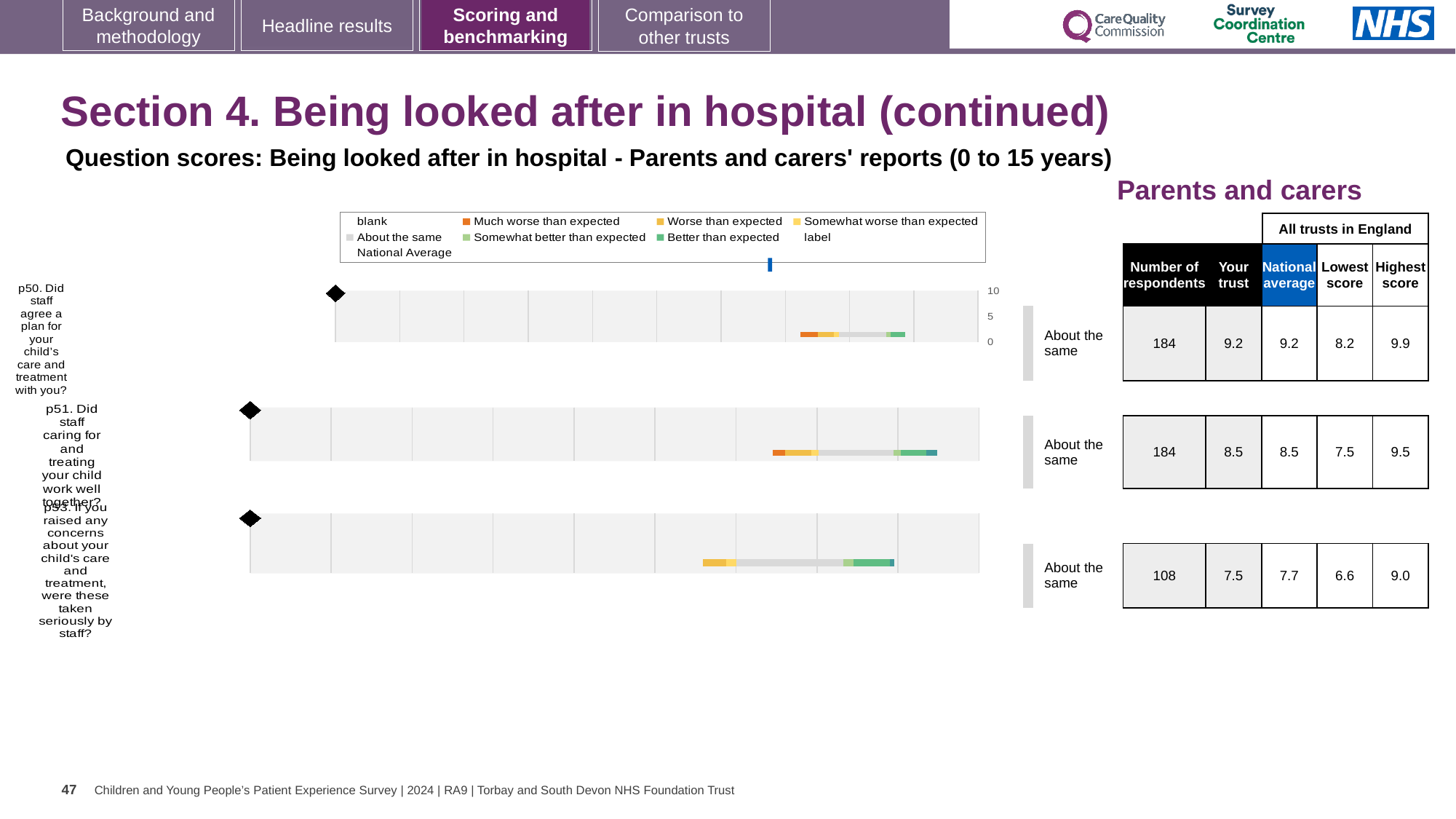
What is the national average score for p53 (If you raised any concerns about your child's care and treatment, were these taken seriously by staff?)? 7.7 Which question has the fewest respondents? p53 What kind of chart is used to show the question scores on this slide? bar chart What is the highest score across all trusts in England for p50? 9.9 What is the lowest score across all trusts in England for p51 (Did staff caring for and treating your child work well together?)? 7.5 What is the 'Your trust' score for p50 (Did staff agree a plan for your child's care and treatment with you?)? 9.2 How many questions are plotted in the charts on this slide? 3 What is the difference between the national average and the 'Your trust' score for p53? 0.2 Which is larger: the 'Your trust' score for p51 or for p53? p51 Which question has the highest 'Your trust' score? p50 How many respondents answered p53? 108 What benchmark rating is shown for each of the three questions on this slide? About the same